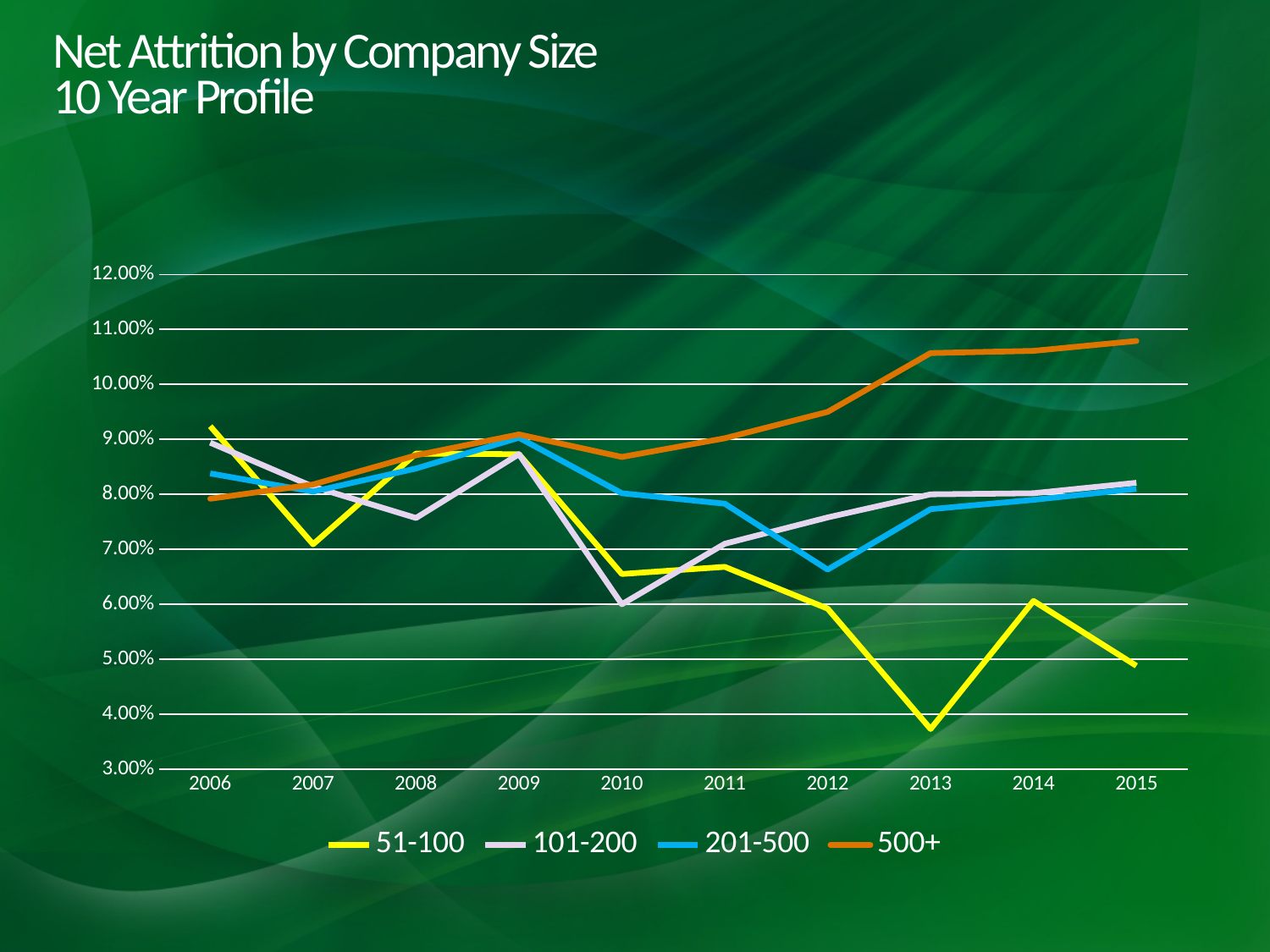
How many years are plotted along the x axis? 10 Does the 500+ series rise or fall from 2012 to 2015? rise In which year does the 51-100 series reach its lowest value? 2013 Is the value for 500+ in 2015 greater or less than 10.00%? greater Is the value for 51-100 in 2013 greater or less than 4.00%? less How many series does the legend list? 4 Is the value for 101-200 in 2010 greater or less than 7.00%? less Which series has the highest value in 2013? 500+ In 2015, which series has the larger value, 500+ or 51-100? 500+ Which series has the lowest value in 2013? 51-100 What kind of chart is shown on the slide? Line chart What is the title of the chart? Net Attrition by Company Size 10 Year Profile